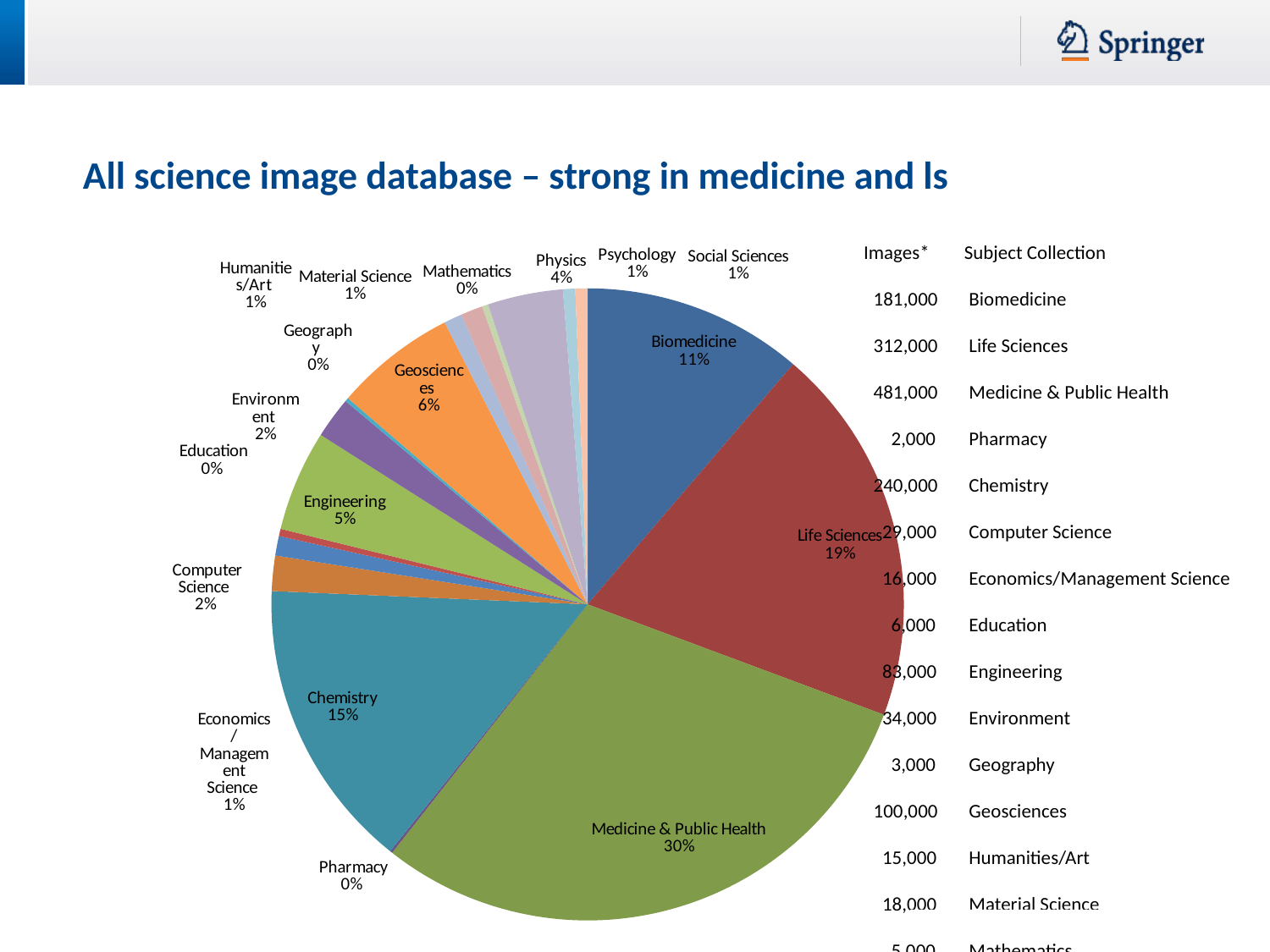
What is the title of the slide containing the chart? All science image database – strong in medicine and ls What share of the pie does Medicine & Public Health have? 30% What share of the pie does Physics have? 4% Which category has the largest share of the pie? Medicine & Public Health What share of the pie does Life Sciences have? 19% What is the difference in percentage points between Medicine & Public Health and Life Sciences? 11 percentage points Which has a larger share of the pie, Chemistry or Engineering? Chemistry How many categories are shown in the pie chart? 18 What kind of chart is shown on the slide? pie chart